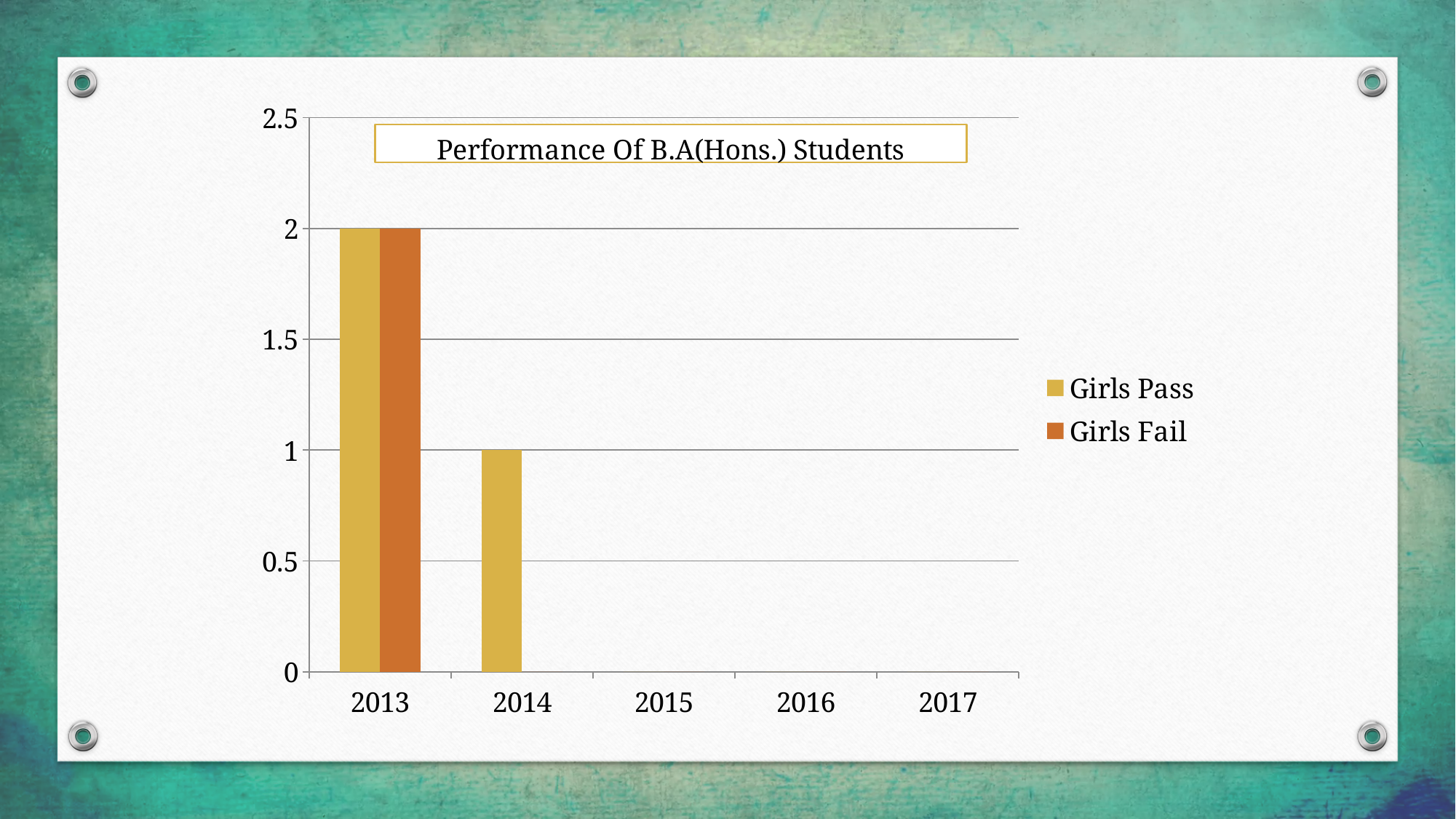
What is the title of the chart? Performance Of B.A(Hons.) Students How many series does the legend list? 2 Which year has the highest Girls Pass value? 2013 Is the Girls Pass value for 2013 larger or smaller than the Girls Pass value for 2014? Larger What is the difference between the Girls Pass values for 2013 and 2014? 1 What is the Girls Pass value for 2013? 2 How many years are shown on the x axis? 5 What is the Girls Pass value for 2014? 1 Does the Girls Pass value rise or fall from 2013 to 2014? Fall Which legend entry is shown in the darker orange colour? Girls Fail What is the Girls Fail value for 2013? 2 What kind of chart is shown on the slide? Bar chart